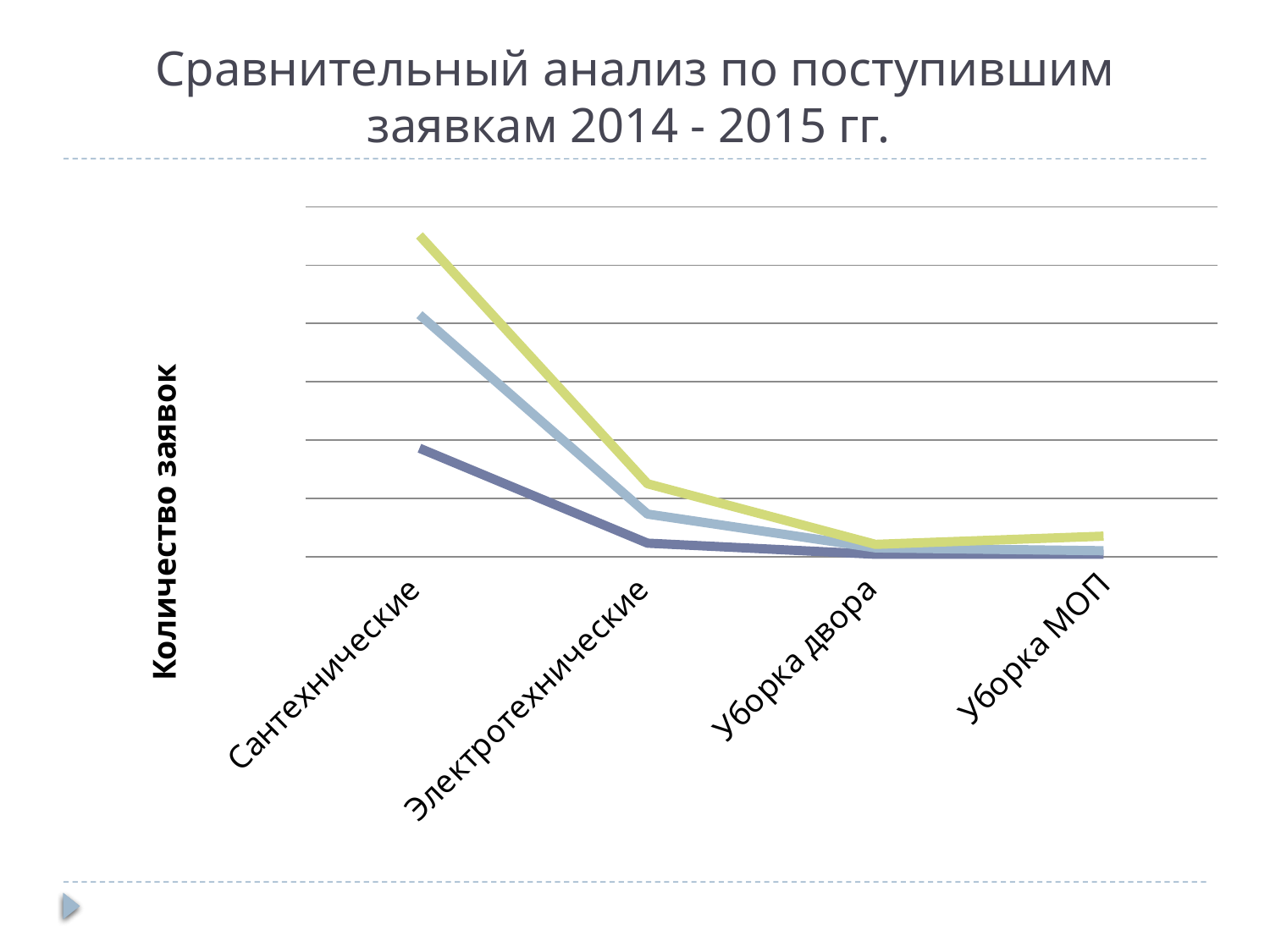
What is the label of the vertical axis of the chart? Количество заявок What is the title of the chart on the slide? Сравнительный анализ по поступившим заявкам 2014 - 2015 гг. What kind of chart is shown on the slide? line chart At the category Электротехнические, which line has the lowest value: the green, light blue or dark blue line? dark blue Which category has the highest value for the green line? Сантехнические How many categories are shown on the x axis of the chart? 4 For the green line, which is larger: the value for Сантехнические or the value for уборка МОП? Сантехнические At the category Сантехнические, which line has the highest value: the green, light blue or dark blue line? green Which category has the highest value for the light blue line? Сантехнические Do the values of the green line rise or fall from Сантехнические to уборка двора? fall How many lines are plotted on the chart? 3 Which category has the highest value for the dark blue line? Сантехнические